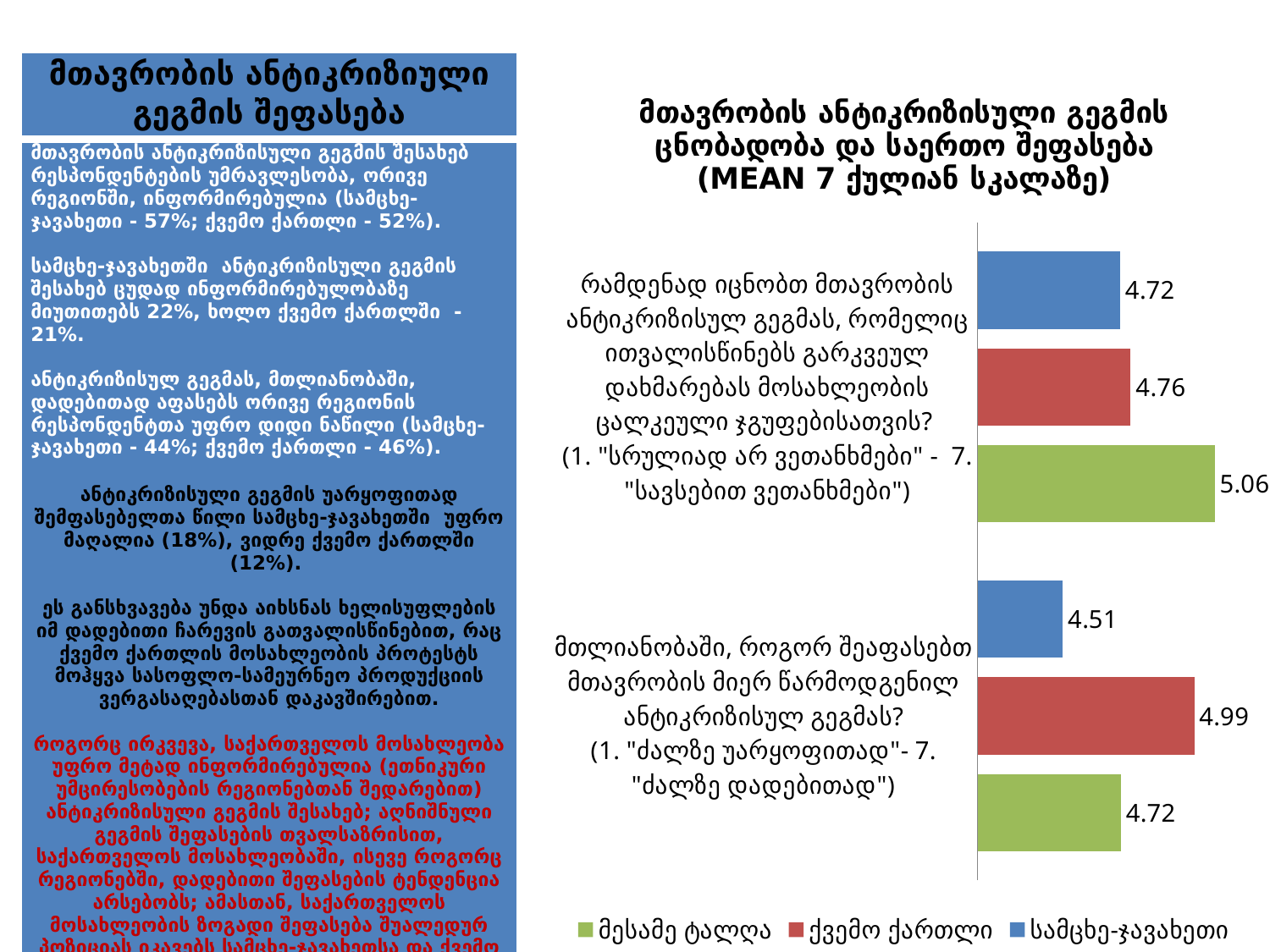
What is the difference between the მესამე ტალღა value and the სამცხე-ჯავახეთი value on the first question (awareness of the anti-crisis plan)? 0.34 How many series does the legend list? 3 What is the value for სამცხე-ჯავახეთი on the first question (awareness of the government's anti-crisis plan)? 4.72 What type of chart is shown on the slide? bar chart What is the value for მესამე ტალღა on the first question (awareness of the government's anti-crisis plan)? 5.06 What is the value for ქვემო ქართლი on the first question (awareness of the government's anti-crisis plan)? 4.76 Which series has the lowest value on the second question (overall assessment of the anti-crisis plan)? სამცხე-ჯავახეთი What colour are the bars for ქვემო ქართლი? red On the second question (overall assessment), which is larger: the value for ქვემო ქართლი or the value for მესამე ტალღა? ქვემო ქართლი What is the value for სამცხე-ჯავახეთი on the second question (overall assessment of the anti-crisis plan)? 4.51 What is the value for ქვემო ქართლი on the second question (overall assessment of the anti-crisis plan)? 4.99 Which series has the highest value on the second question (overall assessment of the anti-crisis plan)? ქვემო ქართლი